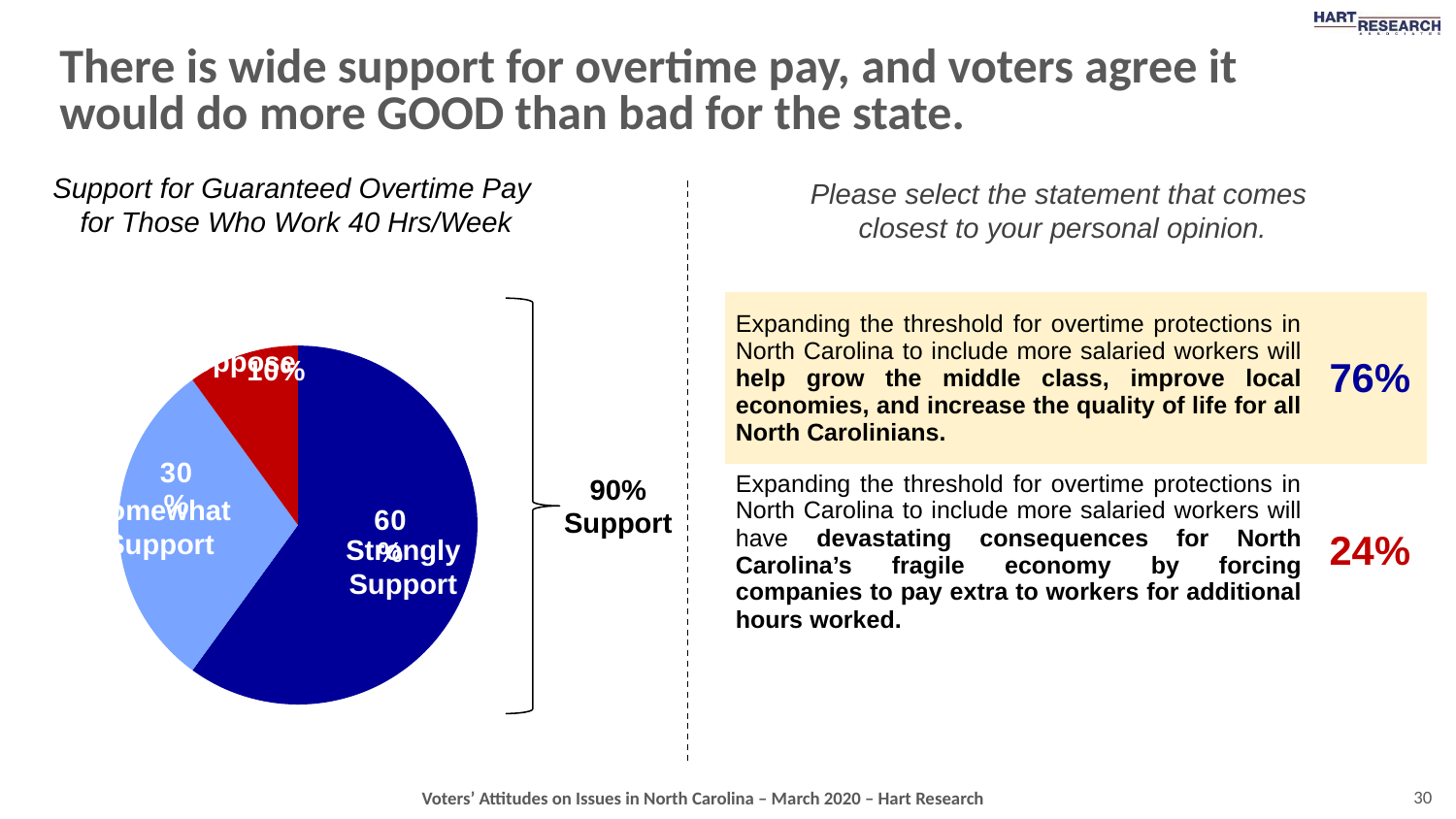
What is the title of the pie chart? Support for Guaranteed Overtime Pay for Those Who Work 40 Hrs/Week What is the difference between the Strongly Support and Somewhat Support shares? 30% What total support percentage does the bracket next to the pie chart indicate? 90% Support Which is larger in the pie chart, Strongly Support or Somewhat Support? Strongly Support What percentage of the pie is Somewhat Support? 30% Which slice of the pie chart is the smallest? Oppose How many slices does the pie chart have? 3 What colour is the Strongly Support slice of the pie chart? dark blue Which slice of the pie chart is the largest? Strongly Support What percentage of the pie is Strongly Support? 60% Is the Strongly Support share of the pie greater or less than 50%? greater What kind of chart is shown on the slide? pie chart